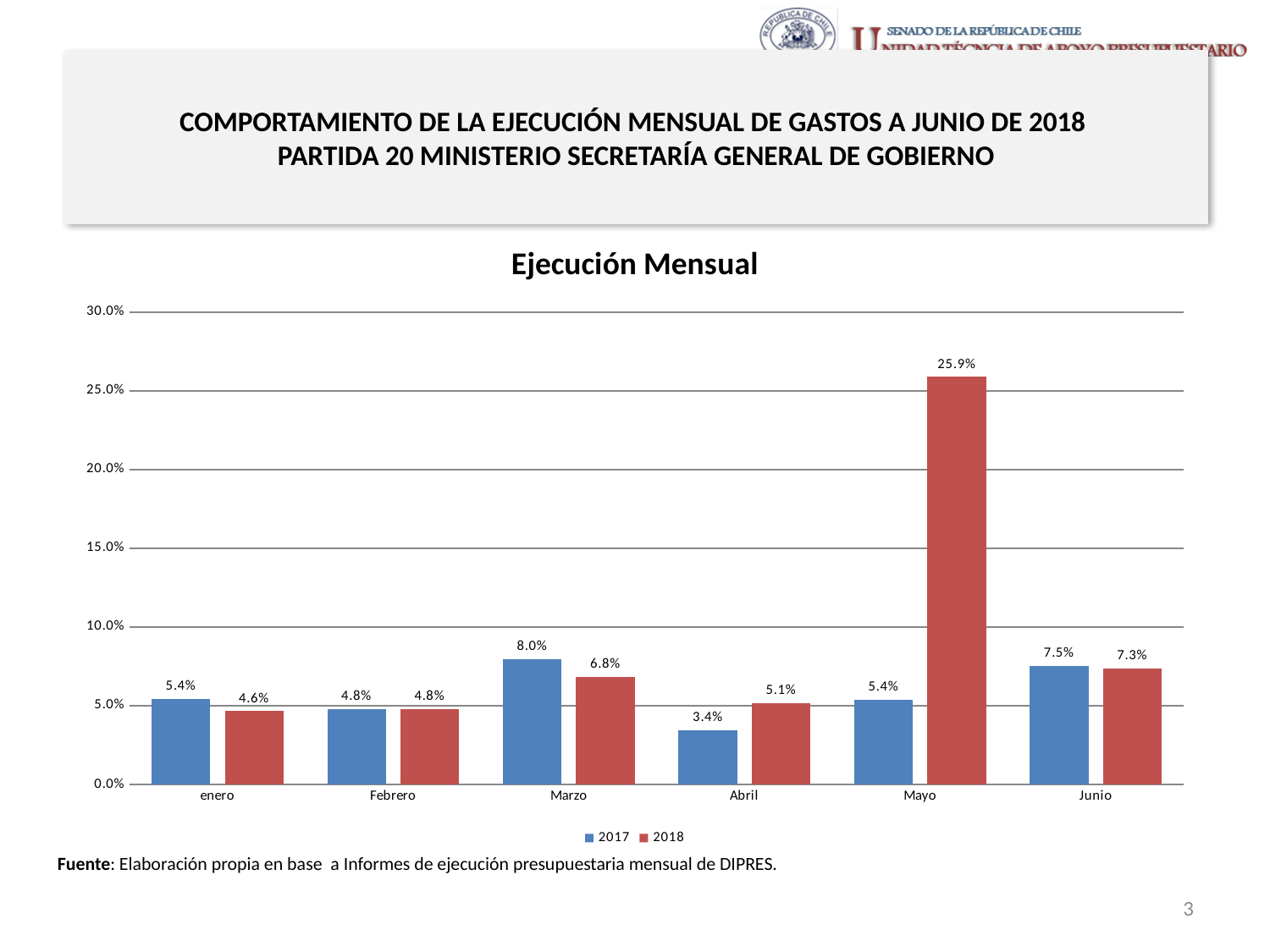
What is the value for 2017 in Abril? 3.4% Which is larger in Junio, the 2017 value or the 2018 value? 2017 Which month has the lowest value for the 2017 series? Abril Is the value for 2018 in Mayo greater or less than 25.0%? greater What is the value for 2017 in Marzo? 8.0% Which month has the highest value for the 2018 series? Mayo What is the value for 2018 in enero? 4.6% What is the value for 2018 in Mayo? 25.9% What type of chart is shown? Bar chart How many months are shown on the x axis? 6 What is the difference between the 2018 and 2017 values in Mayo? 20.5% How many series does the legend list? 2